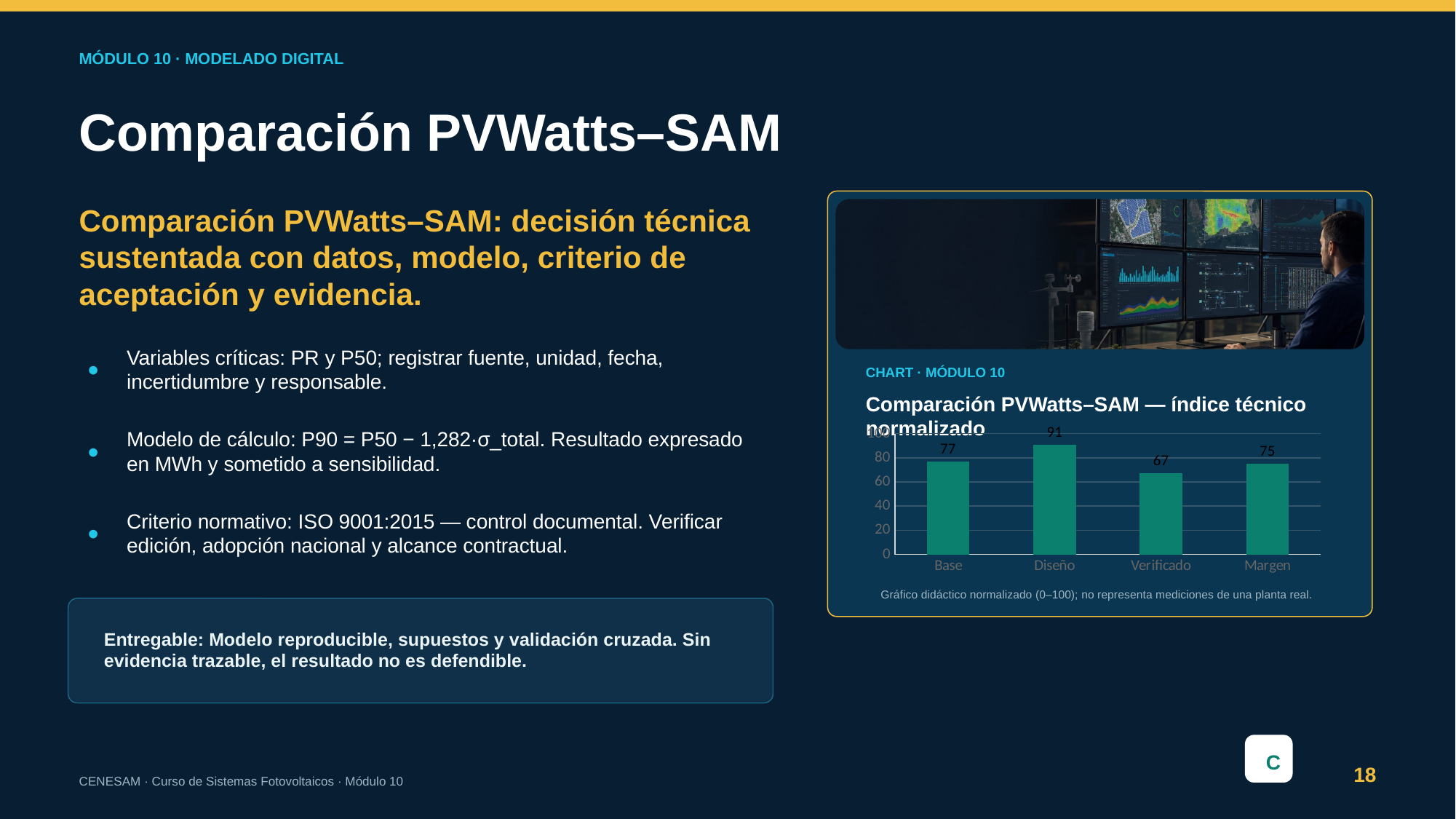
What is the value for Base in the chart? 77 Which is larger, the value for Base or the value for Margen? Base Which category has the lowest value in the chart? Verificado How many categories are shown in the chart? 4 What kind of chart is shown on the slide? Bar chart What is the difference between the values for Diseño and Verificado? 24 Which category has the highest value in the chart? Diseño What is the value for Margen in the chart? 75 What is the value for Verificado in the chart? 67 Is the value for Diseño greater or less than 80? greater What is the value for Diseño in the chart? 91 What is the title of the chart? Comparación PVWatts–SAM — índice técnico normalizado